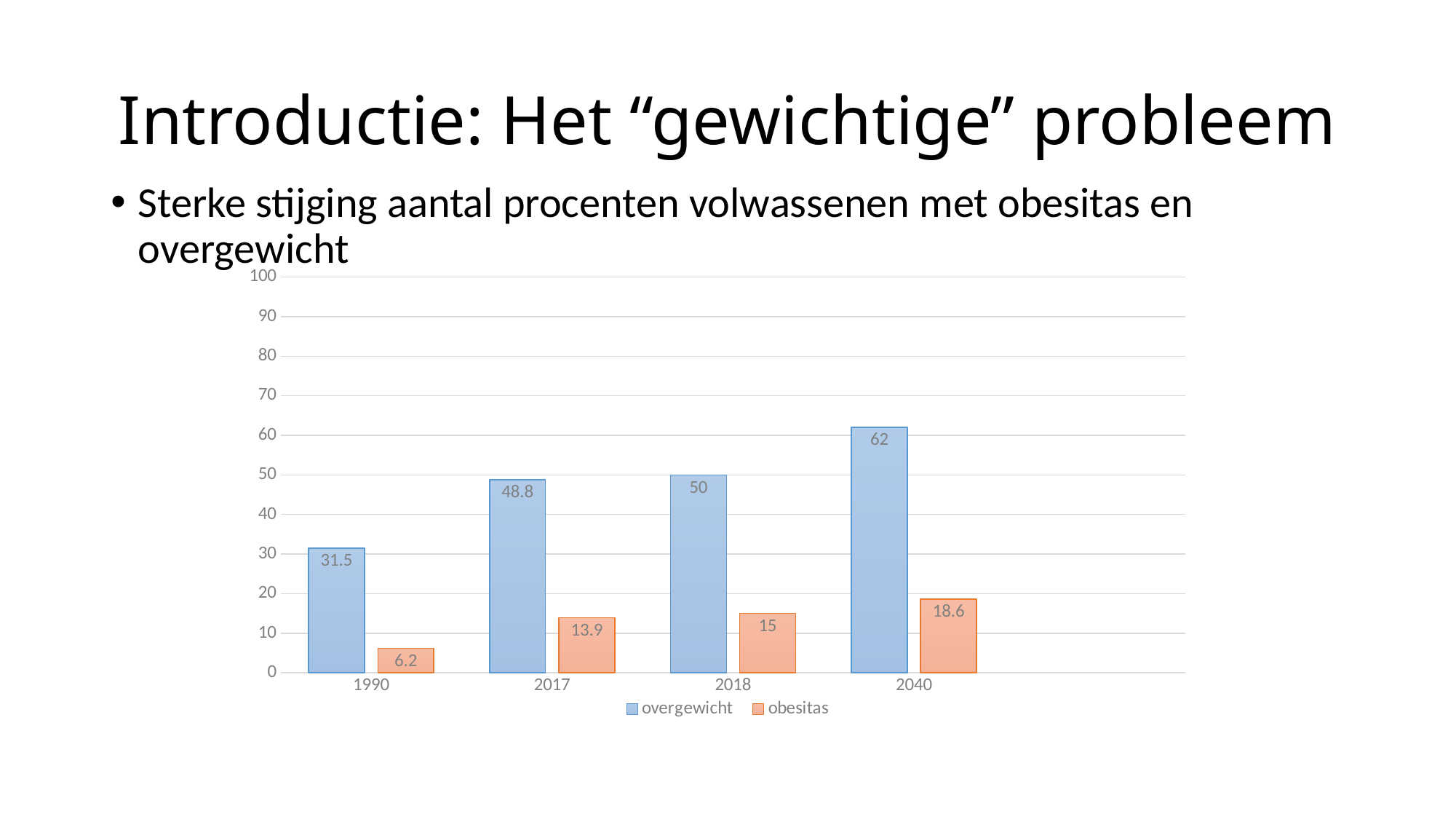
Is the value for overgewicht in 2018 greater or less than 40? greater What kind of chart is shown on the slide? bar chart How many years are shown on the x axis? 4 Which is larger: obesitas in 2018 or obesitas in 2017? obesitas in 2018 What is the value for overgewicht in 1990? 31.5 What is the value for obesitas in 2040? 18.6 Do the obesitas values rise or fall from 1990 to 2040? rise Which year has the highest value for overgewicht? 2040 How many series does the legend list? 2 What is the difference between the overgewicht values for 2040 and 1990? 30.5 Which year has the lowest value for obesitas? 1990 What is the value for obesitas in 2017? 13.9